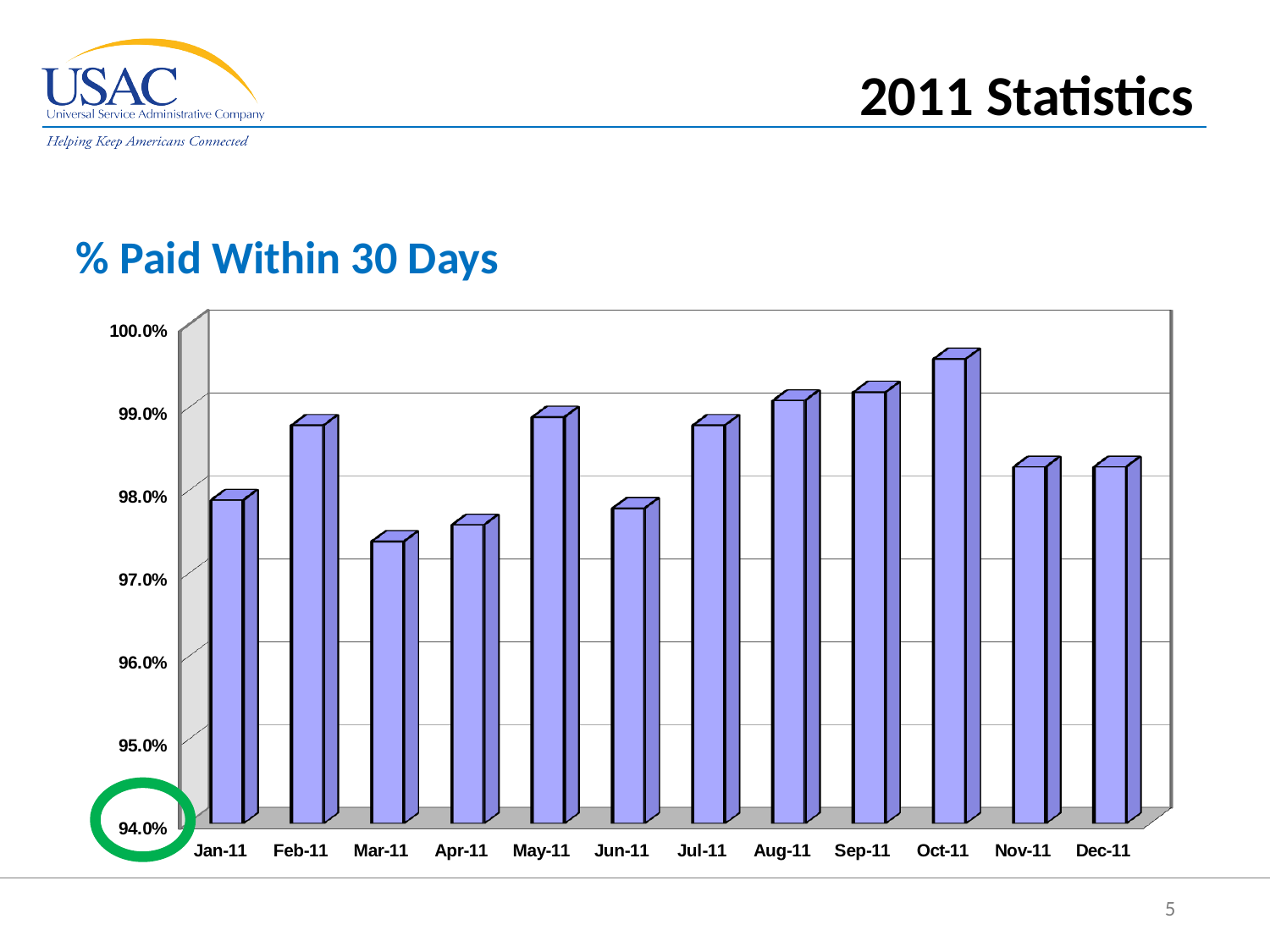
Is the value for Mar-11 greater or less than 98.0%? less Is the value for Feb-11 greater or less than 98.0%? greater How many months are plotted on the chart? 12 Which month has the lowest % paid within 30 days? Mar-11 What is the title of the chart? % Paid Within 30 Days Is the value for Oct-11 greater or less than 99.0%? greater Do the values rise or fall from Jul-11 to Oct-11? Rise Which month has the highest % paid within 30 days? Oct-11 What kind of chart is shown on the slide? Bar chart Which is larger, the value for Oct-11 or the value for Mar-11? Oct-11 Which is larger, the value for Sep-11 or the value for Jun-11? Sep-11